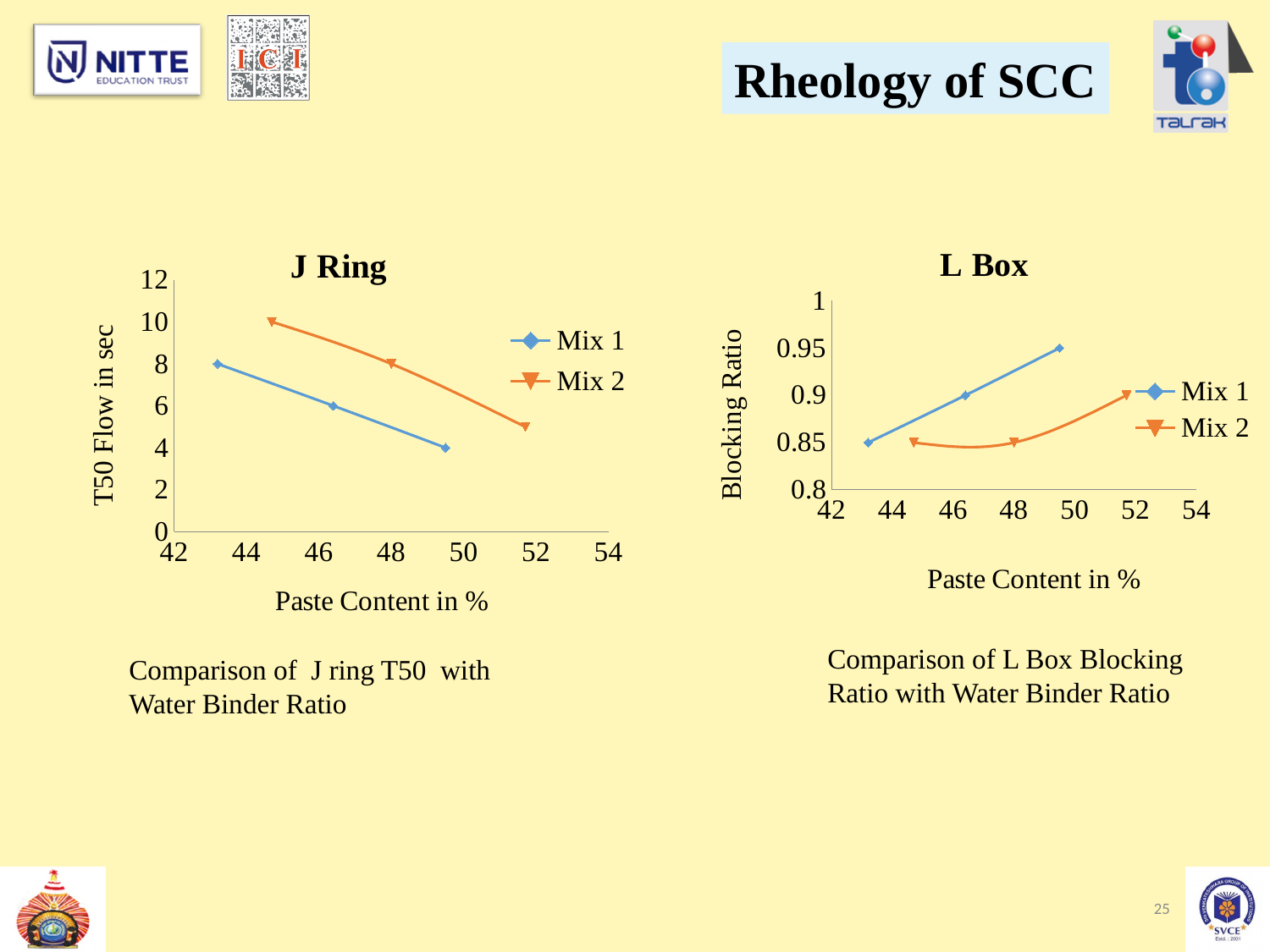
What is the x-axis label of the L Box chart? Paste Content in % In the J Ring chart, is the lowest Mix 1 value greater or less than 6? less What is the y-axis label of the J Ring chart? T50 Flow in sec In the J Ring chart, which series has the higher T50 flow at its first plotted point, Mix 1 or Mix 2? Mix 2 What kind of chart is the J Ring chart? line chart In the J Ring chart, how many data points are plotted for Mix 2? 3 In the L Box chart, which series reaches the higher blocking ratio, Mix 1 or Mix 2? Mix 1 In the L Box chart, is the highest Mix 1 value greater or less than 0.9? greater How many series does the legend of the L Box chart list? 2 In the J Ring chart, do the Mix 1 values rise or fall as paste content increases? fall In the J Ring chart, is the highest Mix 2 value greater or less than 8? greater In the L Box chart, do the Mix 1 values rise or fall as paste content increases? rise